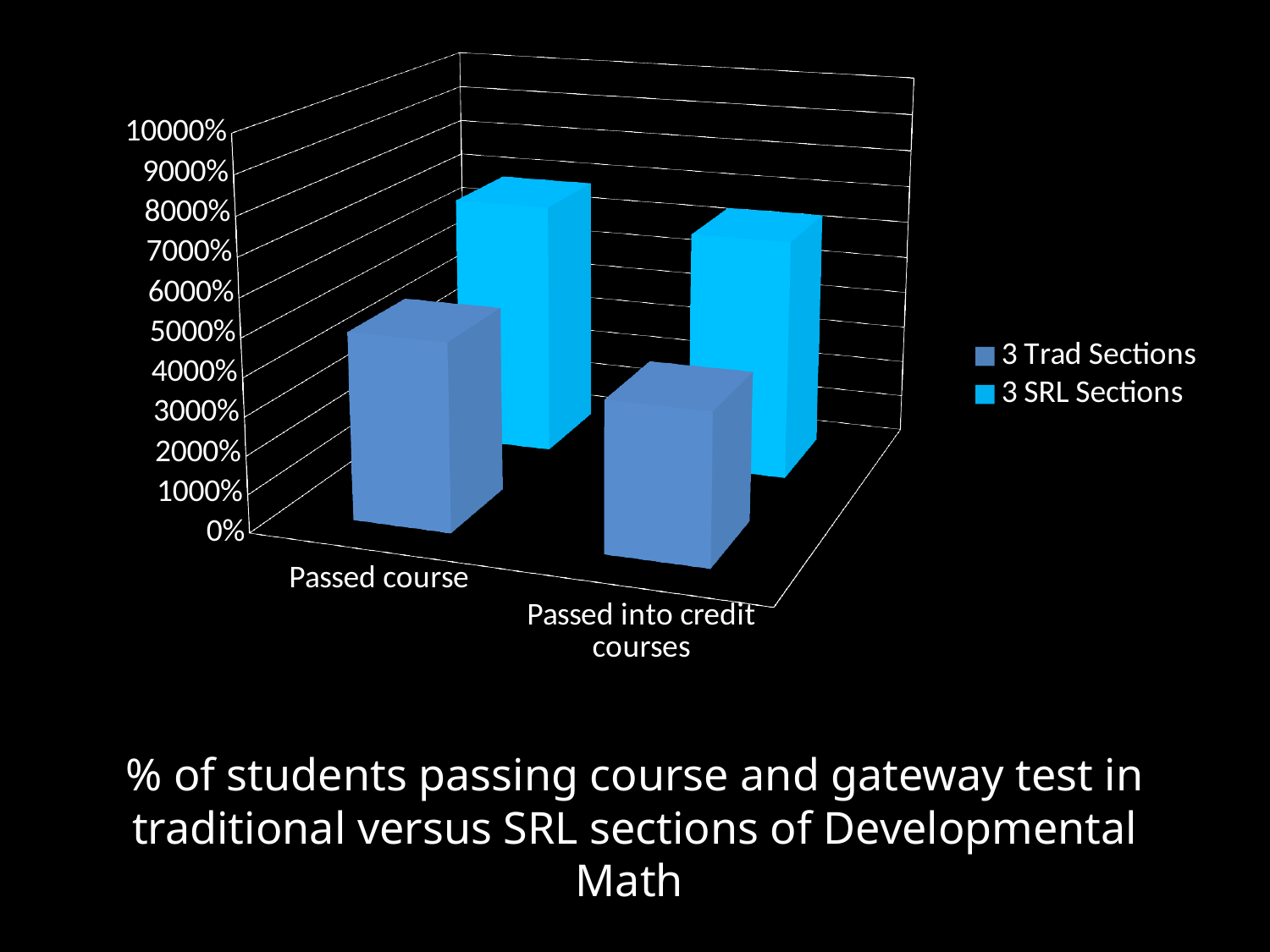
Is the value for 3 SRL Sections in Passed into credit courses greater or less than 5000%? greater What kind of chart is shown on the slide? Bar chart Is the value for 3 SRL Sections in Passed course greater or less than 6000%? greater Is the value for 3 Trad Sections in Passed into credit courses greater or less than 6000%? less For Passed course, which series has the larger value, 3 Trad Sections or 3 SRL Sections? 3 SRL Sections For Passed into credit courses, which series has the larger value, 3 Trad Sections or 3 SRL Sections? 3 SRL Sections How many series does the legend list? 2 What is the title shown below the chart? % of students passing course and gateway test in traditional versus SRL sections of Developmental Math For 3 Trad Sections, which category has the higher value, Passed course or Passed into credit courses? Passed course Which series are listed in the legend? 3 Trad Sections and 3 SRL Sections How many categories are shown on the x axis? 2